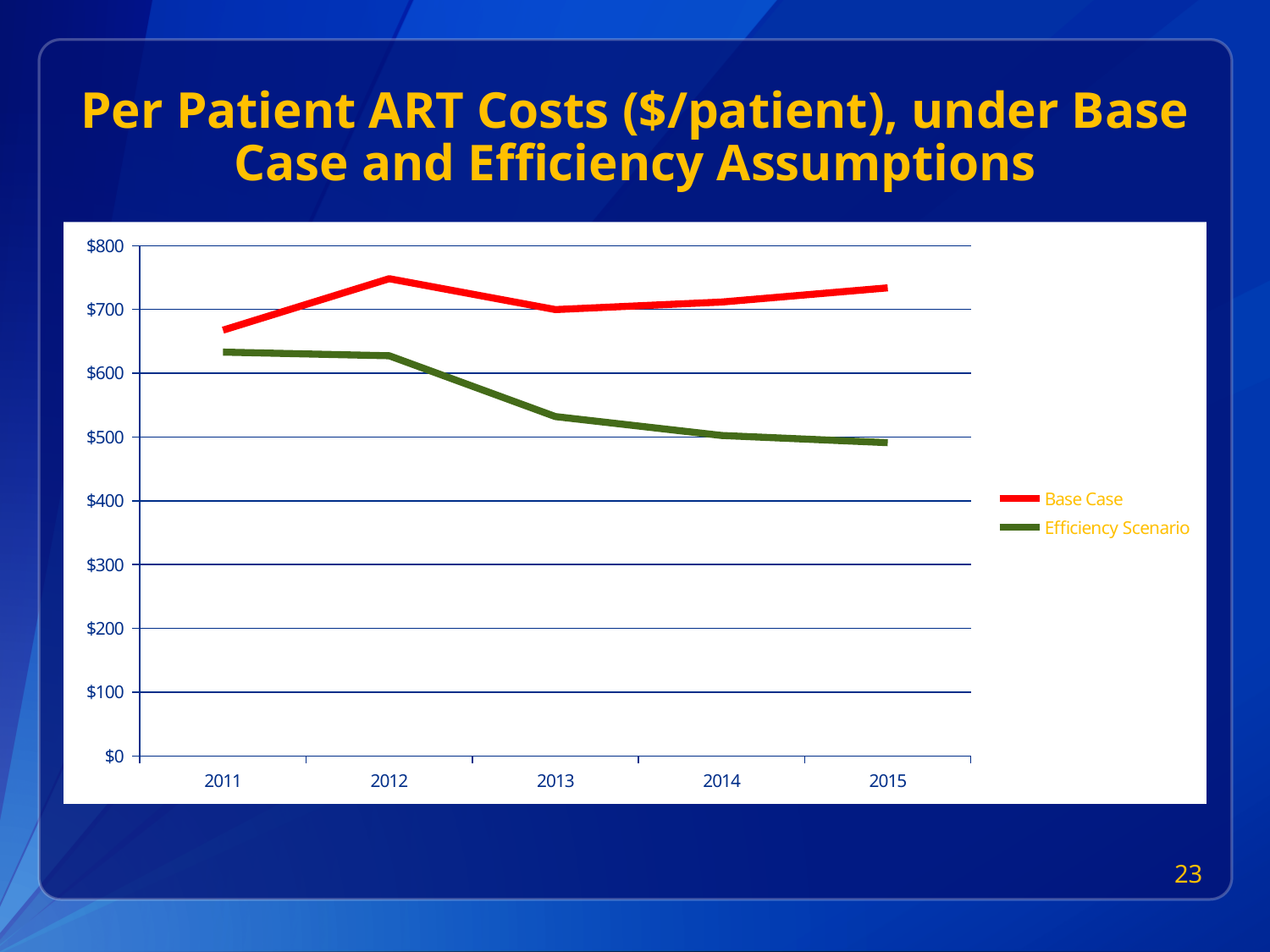
How many years are plotted along the x axis? 5 How many series does the legend list? 2 Is the Base Case value for 2011 greater or less than $700? less In which year is the Base Case per patient ART cost highest? 2012 In 2015, which series has the higher per patient ART cost, Base Case or Efficiency Scenario? Base Case What kind of chart is shown on the slide? line chart Is the Efficiency Scenario value for 2015 greater or less than $600? less Does the Efficiency Scenario line rise or fall from 2011 to 2015? fall Is the Efficiency Scenario value for 2011 greater or less than $600? greater What colour is the Base Case line? red